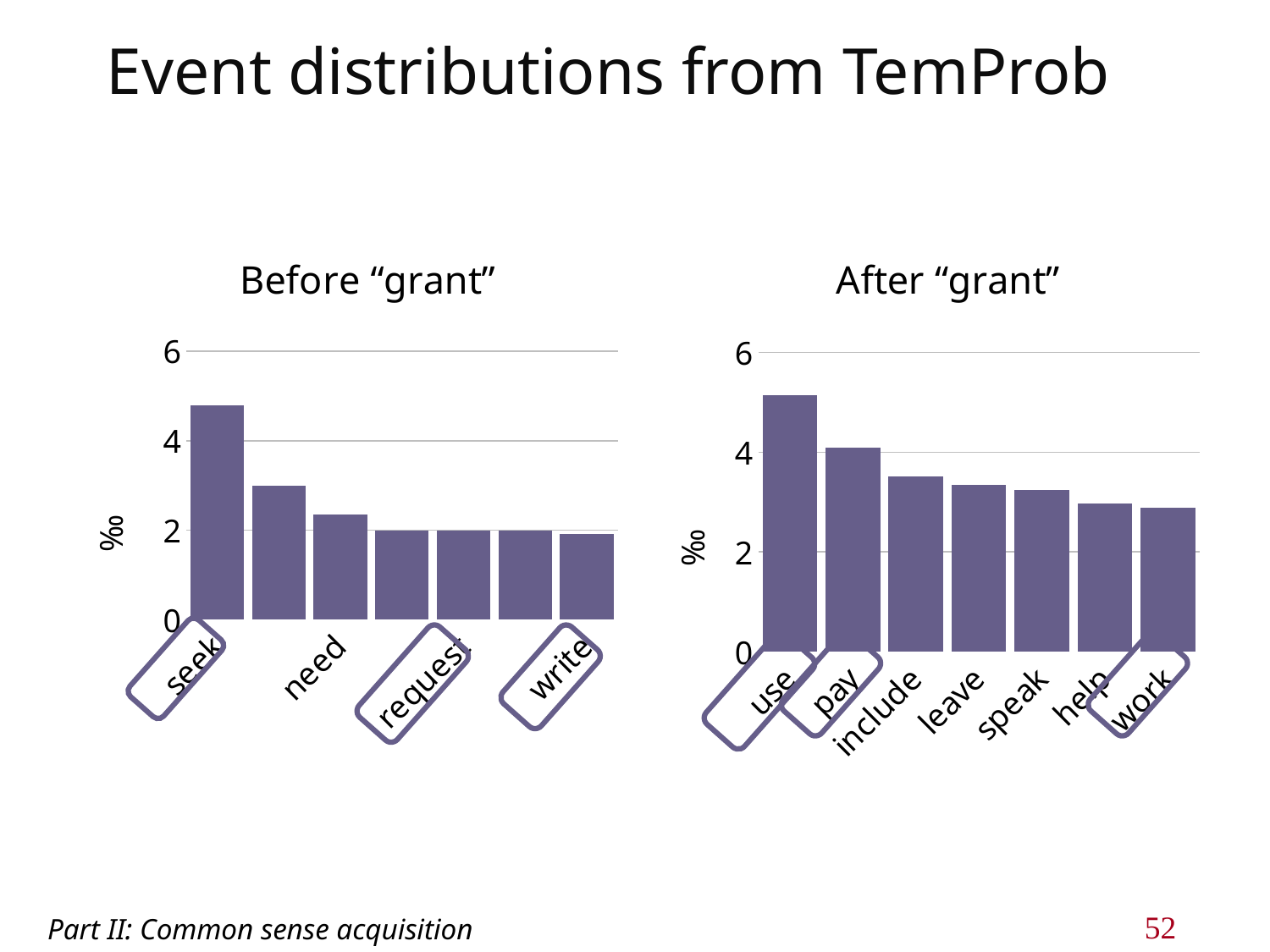
In the "After "grant"" chart, is the value for work greater or less than 4? less In the "After "grant"" chart, which category has the lowest value? work What is the y-axis label on the "Before "grant"" chart? ‰ In the "After "grant"" chart, is the value for use greater or less than 4? greater In the "Before "grant"" chart, which category has the highest value? seek In the "After "grant"" chart, do the values rise or fall from left to right along the x axis? fall What kind of chart is the "Before "grant"" chart? bar chart In the "After "grant"" chart, which category has the highest value? use In the "Before "grant"" chart, is the value for need greater or less than 4? less In the "After "grant"" chart, which is larger, the value for pay or the value for help? pay In the "After "grant"" chart, how many bars are plotted? 7